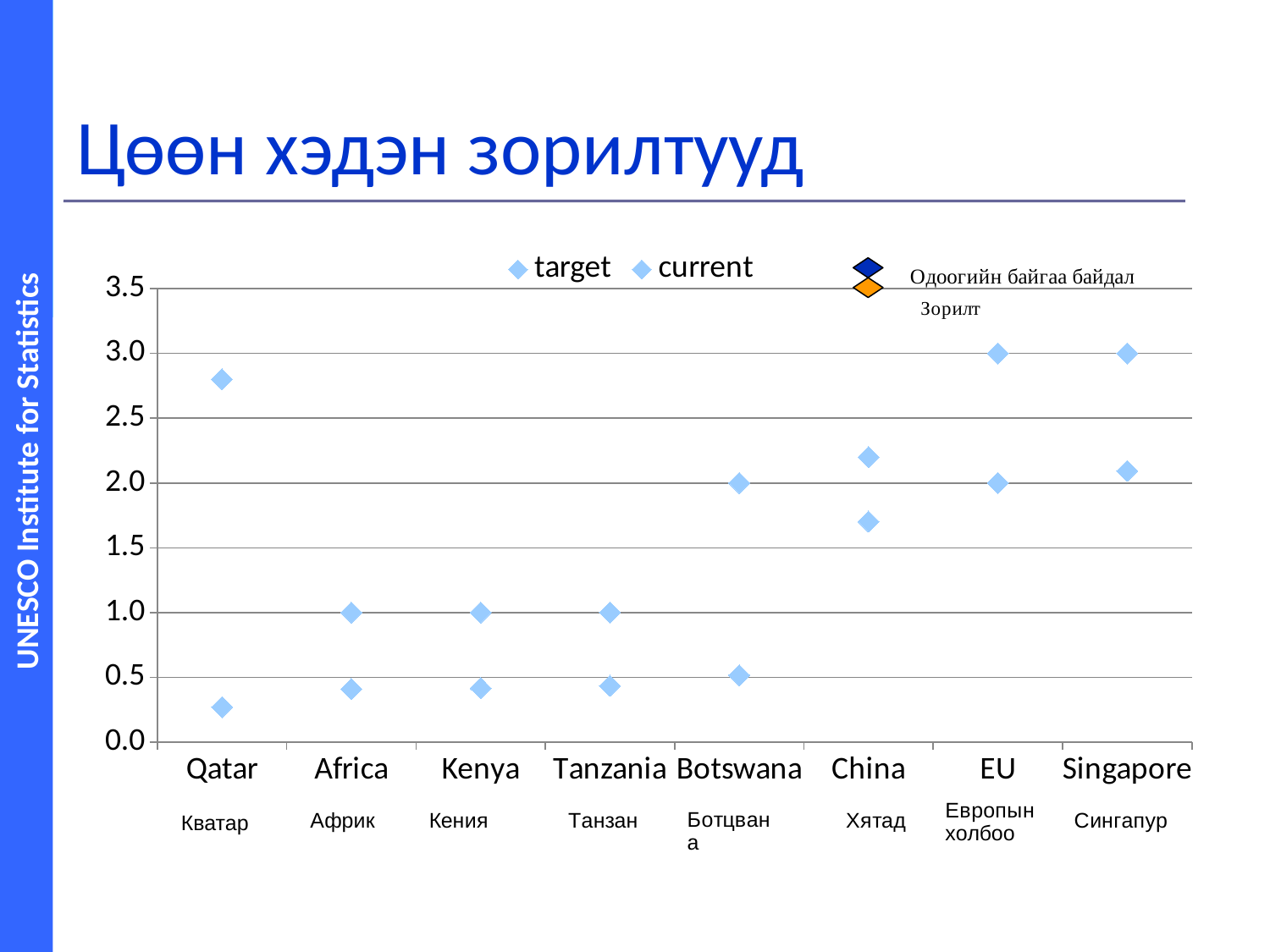
What is the value of the lower of the two points plotted for EU? 2.0 What is the value of the higher of the two points plotted for Botswana? 2.0 What is the value of the higher of the two points plotted for Kenya? 1.0 What is the value of the higher of the two points plotted for Singapore? 3.0 What are the two series named in the chart legend? target and current How many series does the chart legend list? 2 How many countries or regions are shown along the x axis of the chart? 8 Is the lower of the two points for China greater or less than 1.5? greater What is the value of the higher of the two points plotted for EU? 3.0 What kind of chart is shown on the slide? scatter chart Which category has the lowest plotted point on the chart? Qatar Is the higher of the two points for Qatar greater or less than 2.5? greater